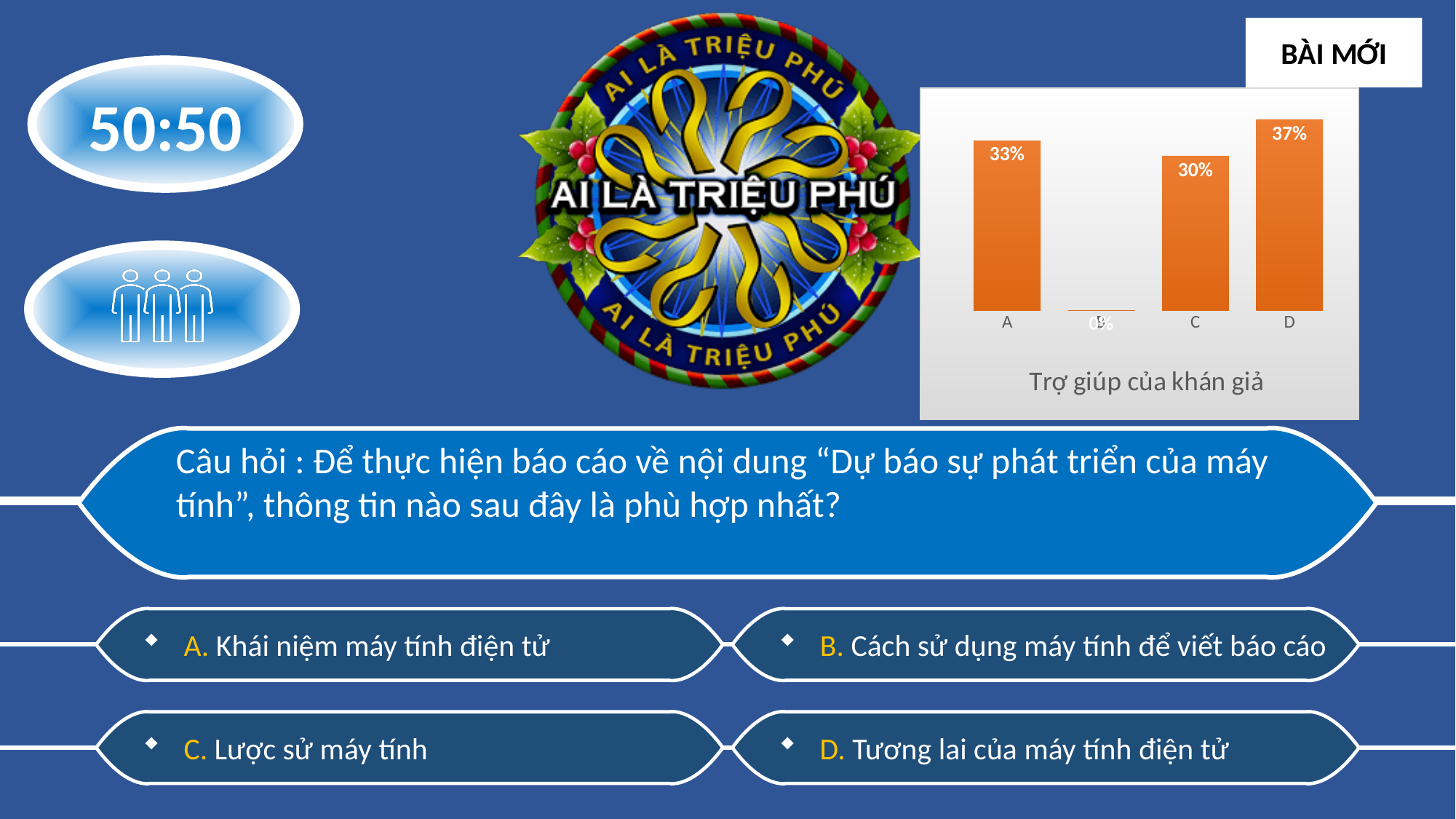
What is the value for category A in the chart? 33% What is the title of the chart? Trợ giúp của khán giả What is the difference between the values for D and C? 7% How many categories are shown on the x axis of the chart? 4 What is the value for category C in the chart? 30% Which is larger, the value for D or the value for A? D What is the value for category D in the chart? 37% Which is larger, the value for A or the value for C? A What kind of chart is shown on the slide? bar chart What colour are the bars in the chart? orange What is the difference between the values for A and C? 3% Which category has the highest value in the chart? D